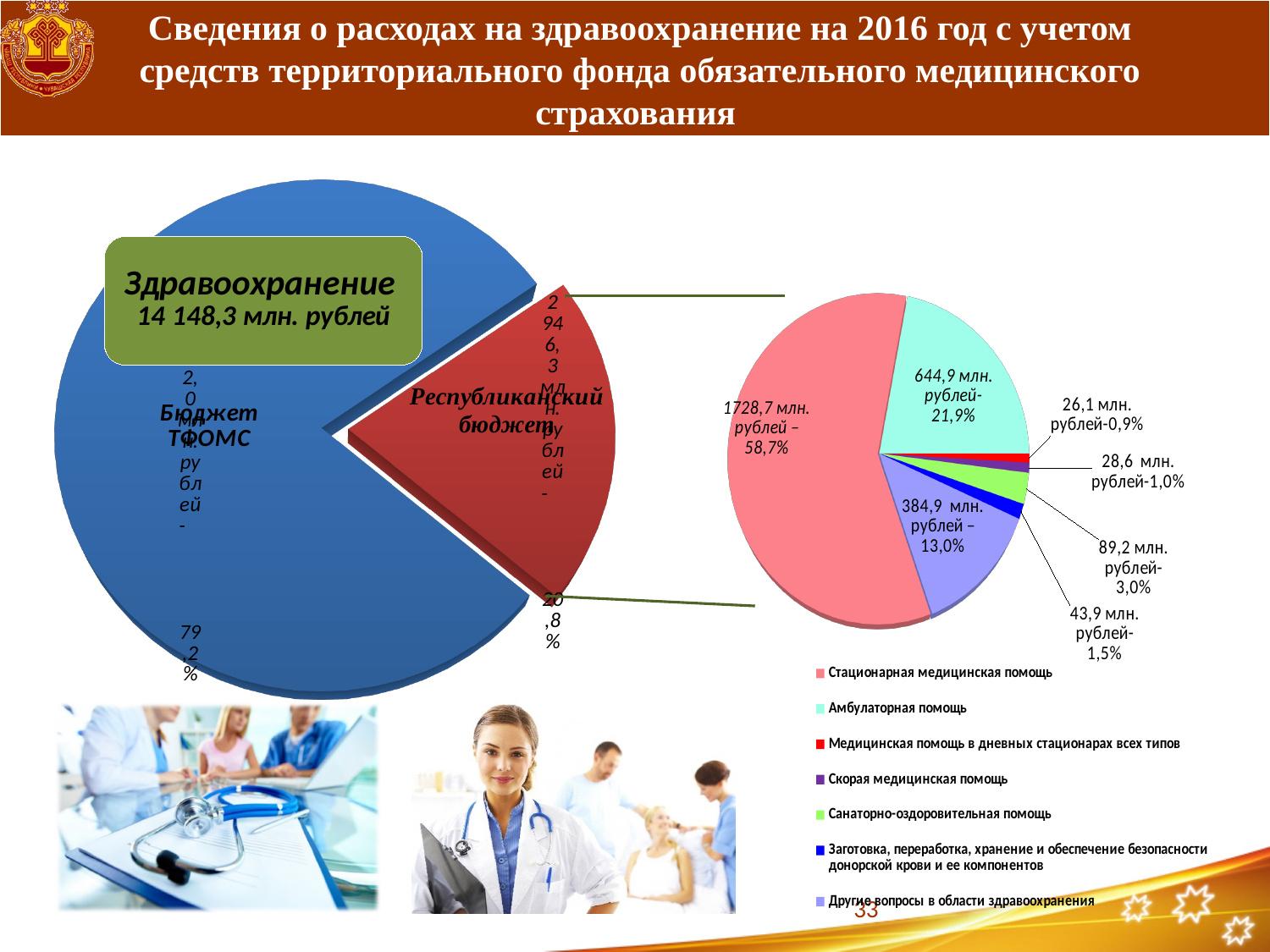
On the right pie chart, what amount is shown for Санаторно-оздоровительная помощь? 89,2 млн. рублей On the right pie chart, what share is shown for Стационарная медицинская помощь? 58,7% On the right pie chart, what share is shown for Другие вопросы в области здравоохранения? 13,0% On the right pie chart, what amount in million rubles is shown for Амбулаторная помощь? 644,9 млн. рублей On the right pie chart, which category has the largest share? Стационарная медицинская помощь On the right pie chart, which category has the smallest share? Медицинская помощь в дневных стационарах всех типов On the right pie chart, which is larger: the share for Амбулаторная помощь or the share for Другие вопросы в области здравоохранения? Амбулаторная помощь What kind of chart is used on the left side of the slide? Pie chart On the right pie chart, how many categories does the legend list? 7 On the right pie chart, what is the difference in percentage points between Стационарная медицинская помощь (58,7%) and Амбулаторная помощь (21,9%)? 36,8 On the left pie chart, what share is shown for Республиканский бюджет? 20,8% On the left pie chart, what share is shown for Бюджет ТФОМС? 79,2%